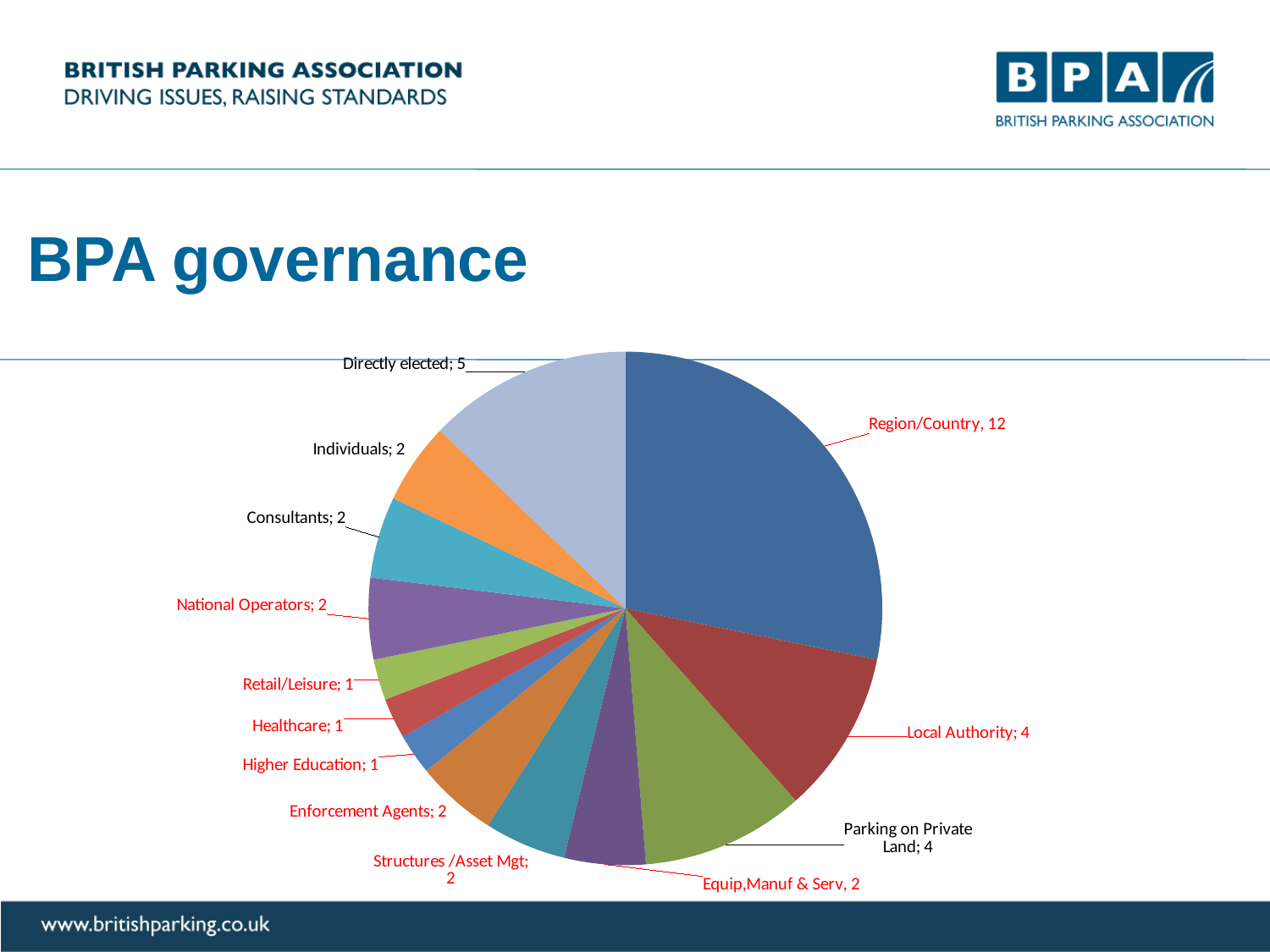
What is the value for Healthcare? 1 Which category has the largest slice of the pie? Region/Country What is the value for Region/Country? 12 What is the title of the slide containing the pie chart? BPA governance How many slices does the pie chart have? 13 What is the value for Directly elected? 5 Which is larger, the value for Directly elected or the value for Local Authority? Directly elected What type of chart is shown on the slide? pie chart What is the difference between the values for Region/Country and Directly elected? 7 What is the value for Local Authority? 4